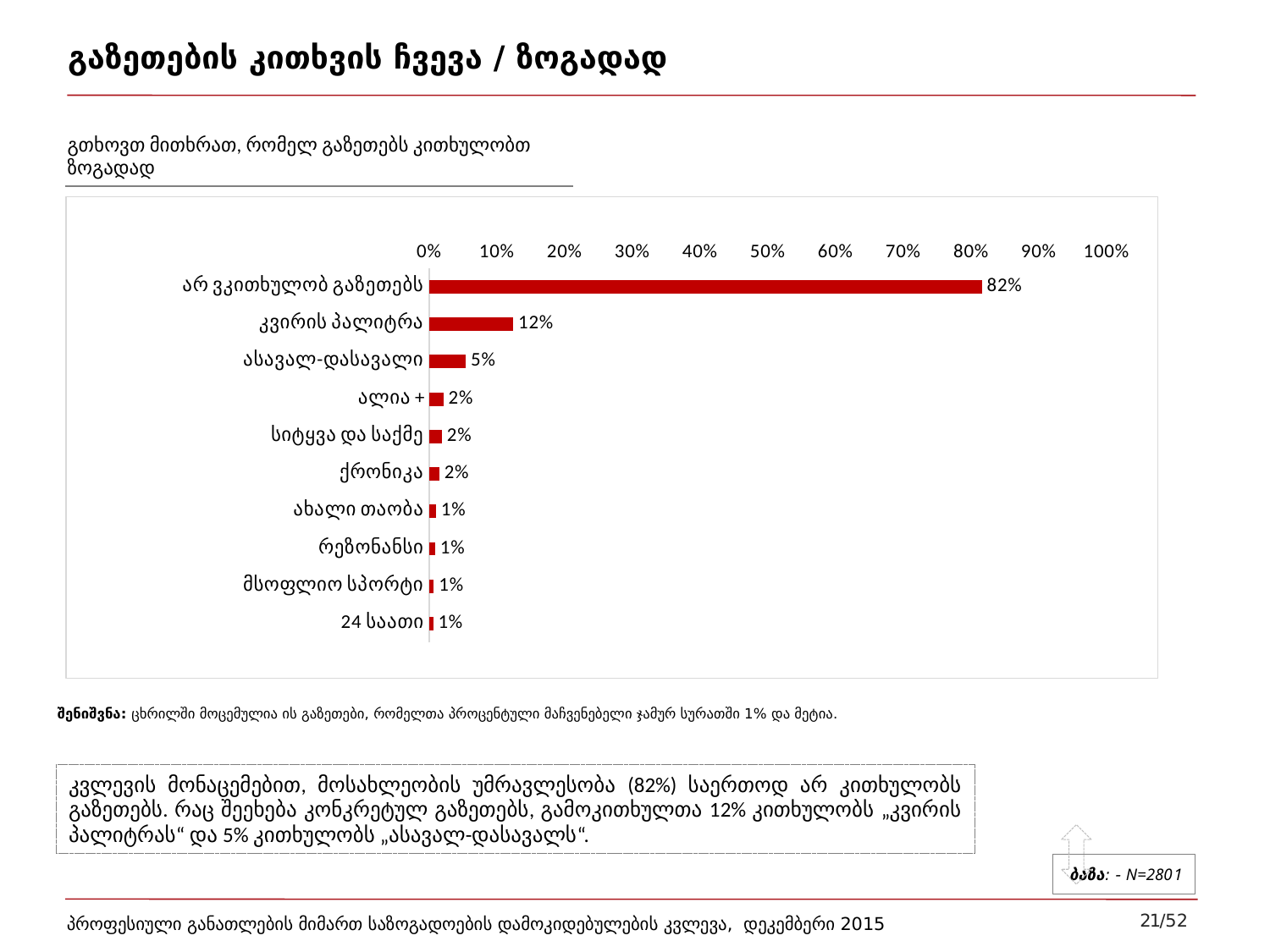
What type of chart is shown on the slide? bar chart What is the value shown for "ქრონიკა"? 2% What is the difference between the values for "არ ვკითხულობ გაზეთებს" and "კვირის პალიტრა"? 70% What is the difference between the values for "კვირის პალიტრა" and "ასავალ-დასავალი"? 7% Which has a larger value, "ასავალ-დასავალი" or "ალია +"? ასავალ-დასავალი What is the value shown for "კვირის პალიტრა"? 12% Is the value for "არ ვკითხულობ გაზეთებს" greater or less than 80%? greater Which category has the highest value in the chart? არ ვკითხულობ გაზეთებს What is the value shown for "ასავალ-დასავალი"? 5% What is the value shown for "24 საათი"? 1% What percentage of respondents answered "არ ვკითხულობ გაზეთებს"? 82% How many categories are shown in the chart? 10